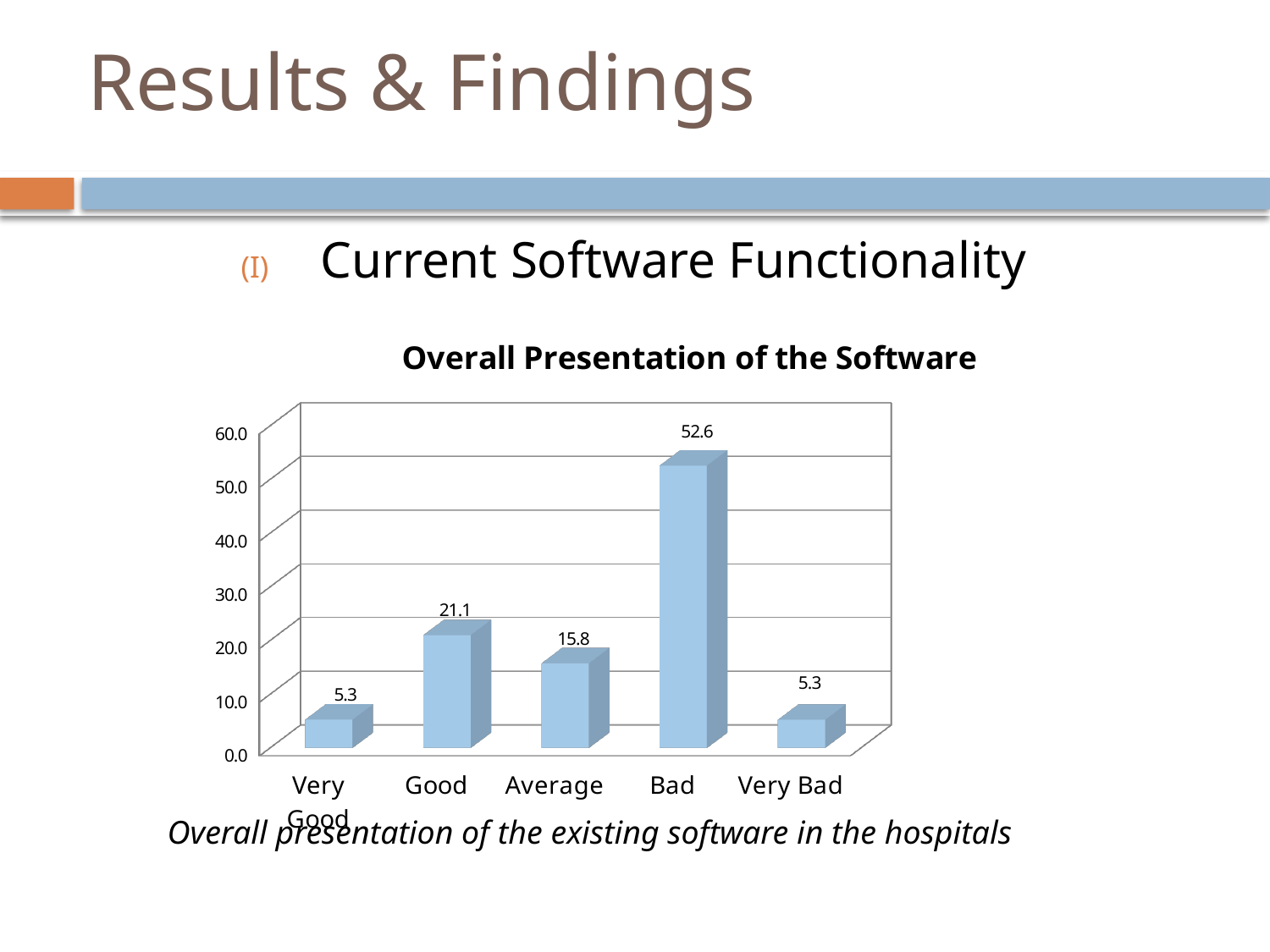
What is the difference between the values for Bad and Good? 31.5 How many categories are shown on the x axis? 5 What kind of chart is shown on the slide? bar chart What is the difference between the values for Good and Average? 5.3 Which is larger, the value for Good or the value for Average? Good Which category has the highest value? Bad Is the value for Bad greater or less than 50.0? greater What is the value for Good? 21.1 What is the title of the chart? Overall Presentation of the Software What is the value for Bad? 52.6 What is the value for Average? 15.8 What is the value for Very Good? 5.3